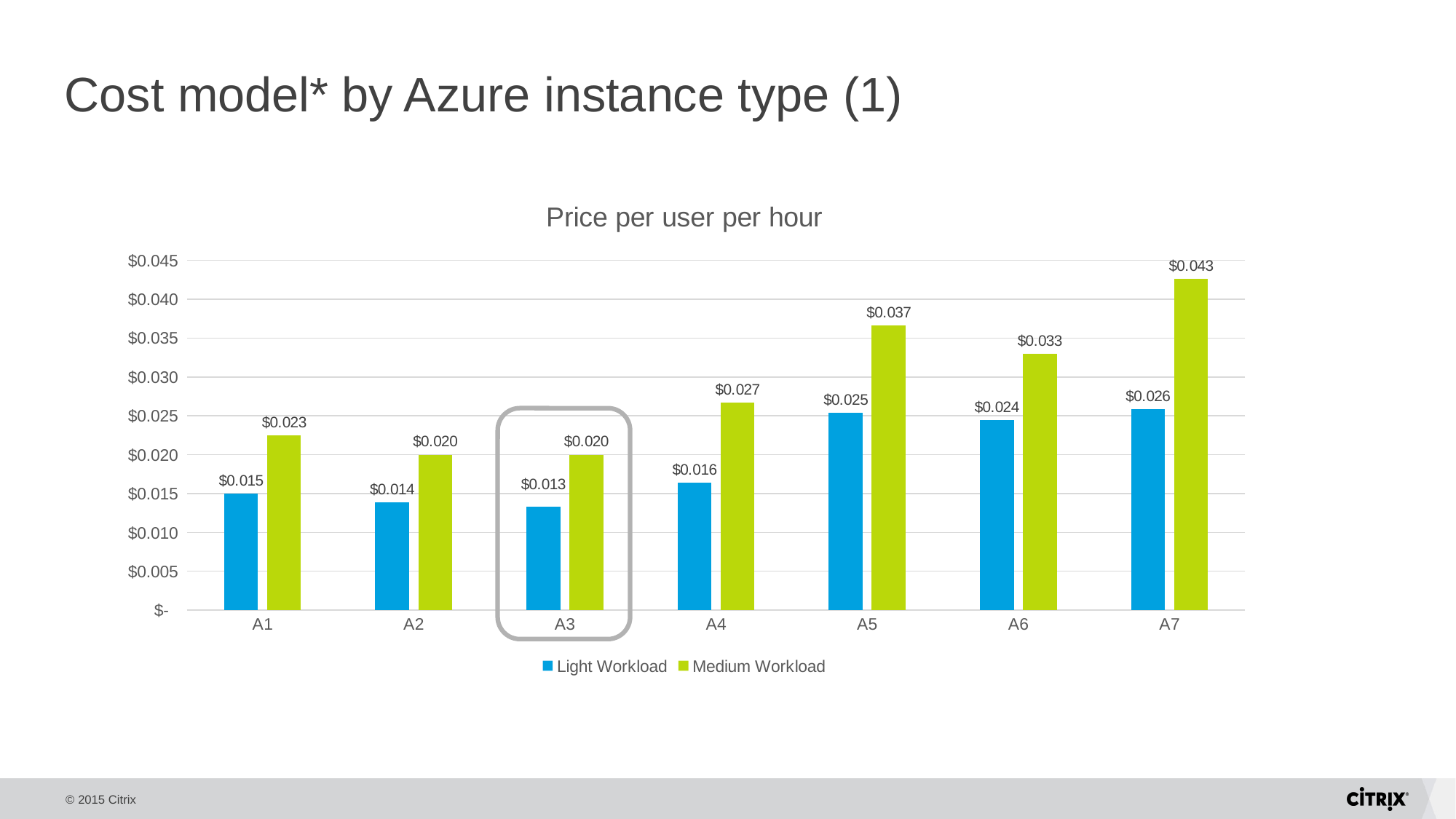
Which is larger, the Light Workload price for A5 or the Light Workload price for A4? A5 What is the title of the chart? Price per user per hour What is the Medium Workload price per user per hour for A7? $0.043 What is the Light Workload price per user per hour for A3? $0.013 Which instance type has the highest Medium Workload price? A7 What kind of chart is shown on the slide? Bar chart How many series does the legend list? 2 Is the Medium Workload value for A6 greater or less than $0.030? greater What is the difference between the Medium Workload and Light Workload prices for A7? $0.017 What is the Medium Workload value for A5? $0.037 How many instance types are shown on the x axis? 7 Which instance type has the lowest Light Workload price? A3